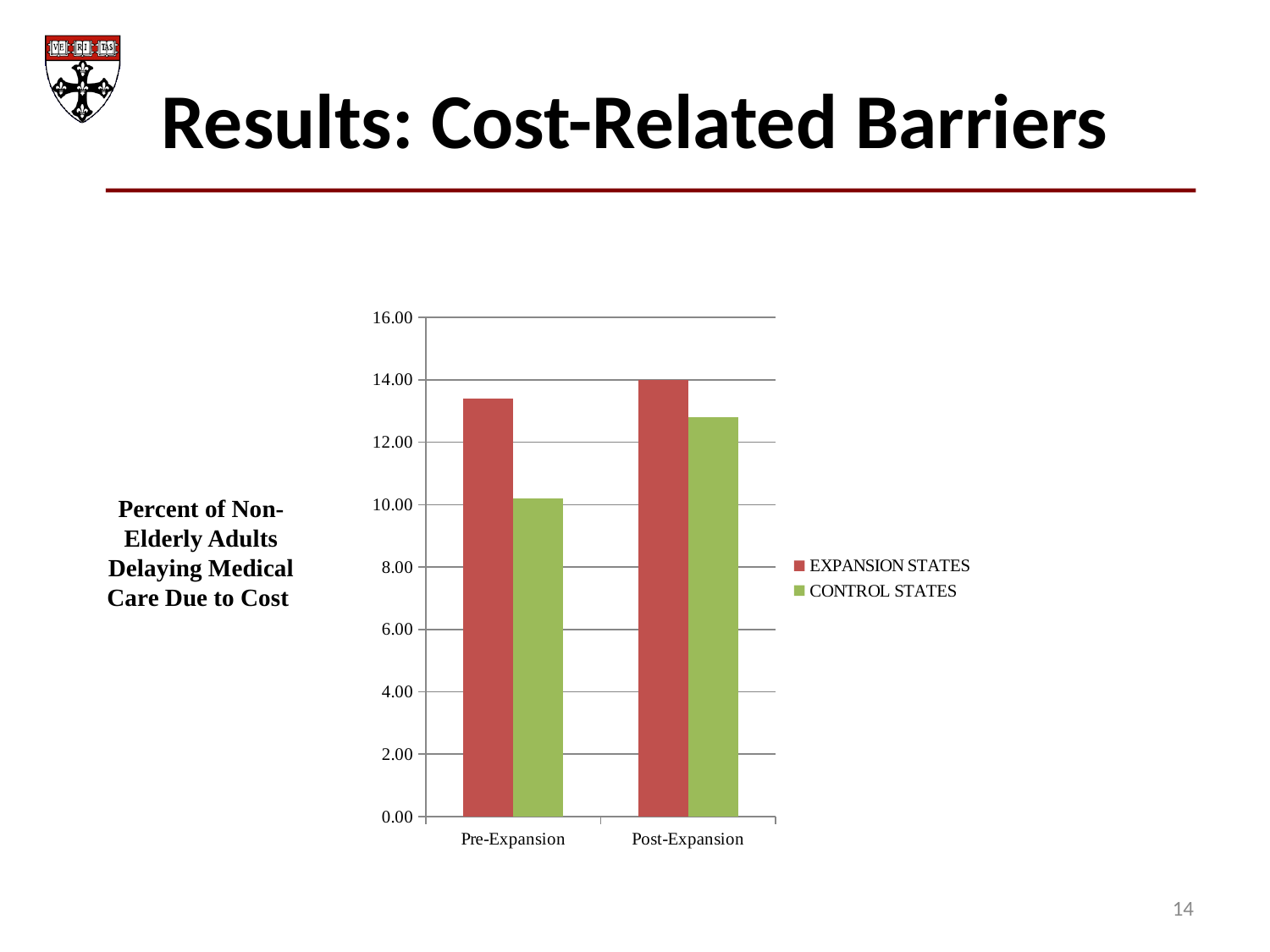
What kind of chart is shown on the slide? bar chart Does the value for CONTROL STATES rise or fall from Pre-Expansion to Post-Expansion? rise Which series has the higher value for Pre-Expansion, EXPANSION STATES or CONTROL STATES? EXPANSION STATES Which category has the lowest value for CONTROL STATES? Pre-Expansion Which series has the higher value for Post-Expansion, EXPANSION STATES or CONTROL STATES? EXPANSION STATES What does the text to the left of the chart say the chart measures? Percent of Non-Elderly Adults Delaying Medical Care Due to Cost How many series does the legend list? 2 How many categories are shown on the x axis? 2 Is the value for CONTROL STATES at Post-Expansion greater or less than 12.00? greater What colour are the bars for CONTROL STATES? green Is the value for CONTROL STATES at Pre-Expansion greater or less than 12.00? less Is the value for EXPANSION STATES at Pre-Expansion greater or less than 12.00? greater